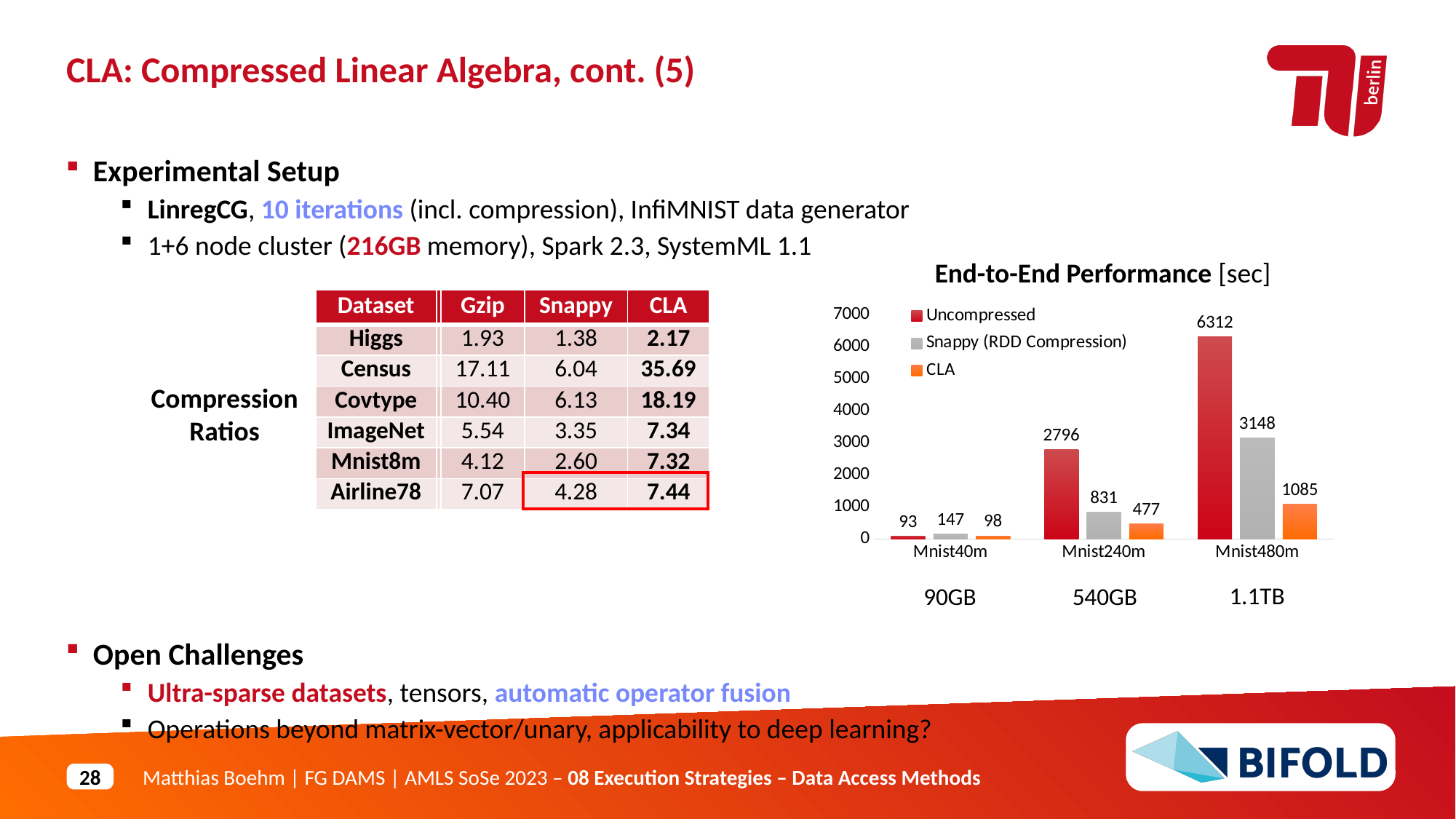
What is the difference between the Uncompressed and CLA values for Mnist480m in the End-to-End Performance chart? 5227 What is the Uncompressed value for Mnist480m in the End-to-End Performance chart? 6312 Which dataset has the highest Uncompressed value in the End-to-End Performance chart? Mnist480m What unit is given in the title of the End-to-End Performance chart? sec How many series does the legend of the End-to-End Performance chart list? 3 What is the Snappy (RDD Compression) value for Mnist40m in the End-to-End Performance chart? 147 For Mnist240m, which is larger in the End-to-End Performance chart: the Snappy (RDD Compression) value or the CLA value? Snappy (RDD Compression) Is the Snappy (RDD Compression) value for Mnist480m greater or less than 3000 in the End-to-End Performance chart? greater What kind of chart is the End-to-End Performance chart? bar chart Which dataset has the lowest CLA value in the End-to-End Performance chart? Mnist40m What is the CLA value for Mnist240m in the End-to-End Performance chart? 477 How many dataset categories are shown on the x axis of the End-to-End Performance chart? 3